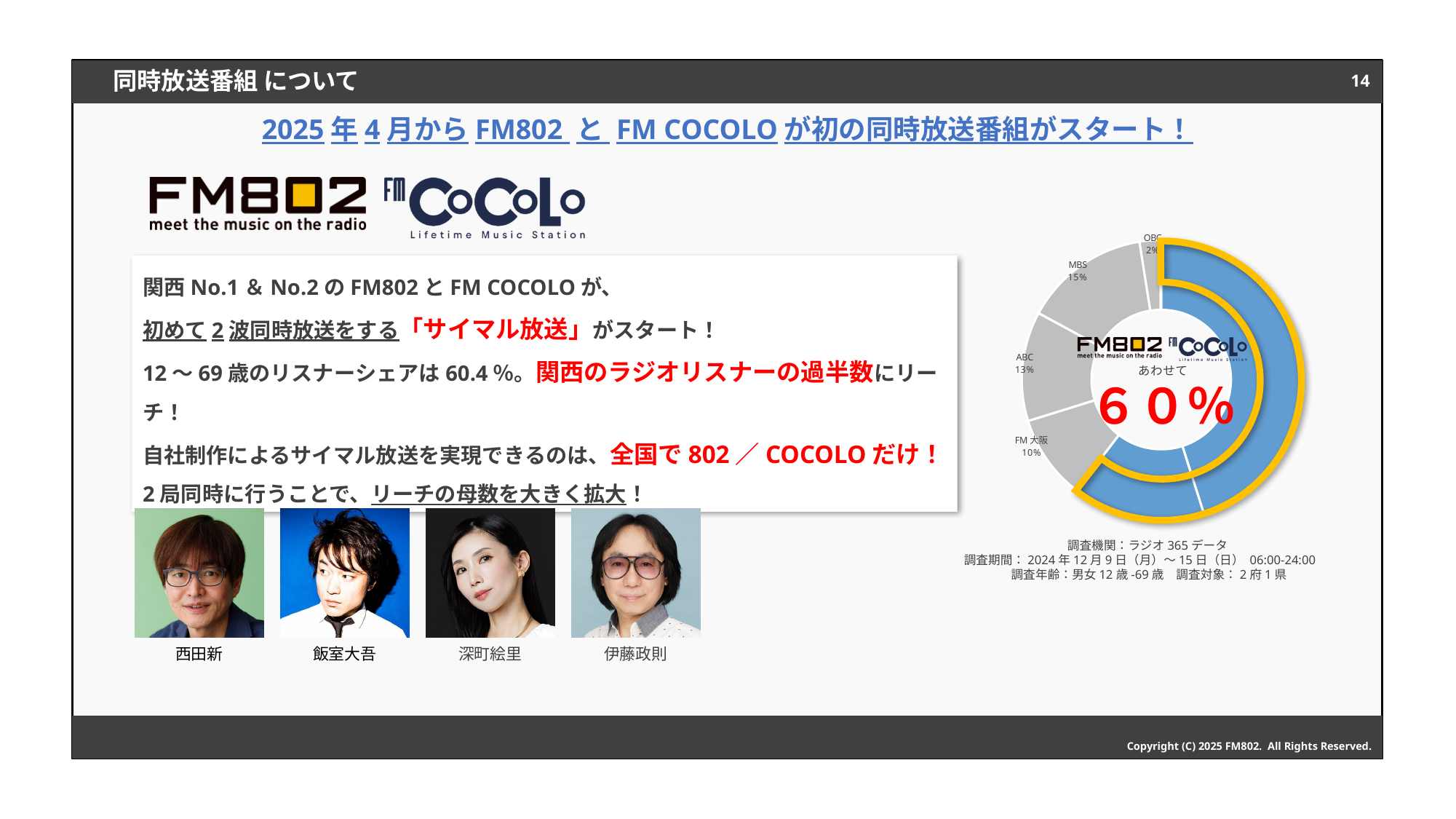
In the donut chart, what share is shown for OBC? 2% In the donut chart, which has the larger share, MBS or FM大阪? MBS In the donut chart, what share is shown for ABC? 13% Among the grey-labelled stations in the donut chart (OBC, MBS, ABC, FM大阪), which has the smallest share? OBC What combined share is printed in the centre of the donut chart for FM802 and FM COCOLO? 60% What kind of chart is shown on the right of the slide? Donut (pie) chart Among the grey-labelled stations in the donut chart (OBC, MBS, ABC, FM大阪), which has the largest share? MBS What is the total share of the four grey-labelled stations (OBC, MBS, ABC, FM大阪) in the donut chart? 40% What colour are the FM802 and FM COCOLO segments in the donut chart? Blue In the donut chart, what share is shown for FM大阪? 10% In the donut chart, what share is shown for MBS? 15% In the donut chart, how many percentage points larger is MBS's share than ABC's share? 2